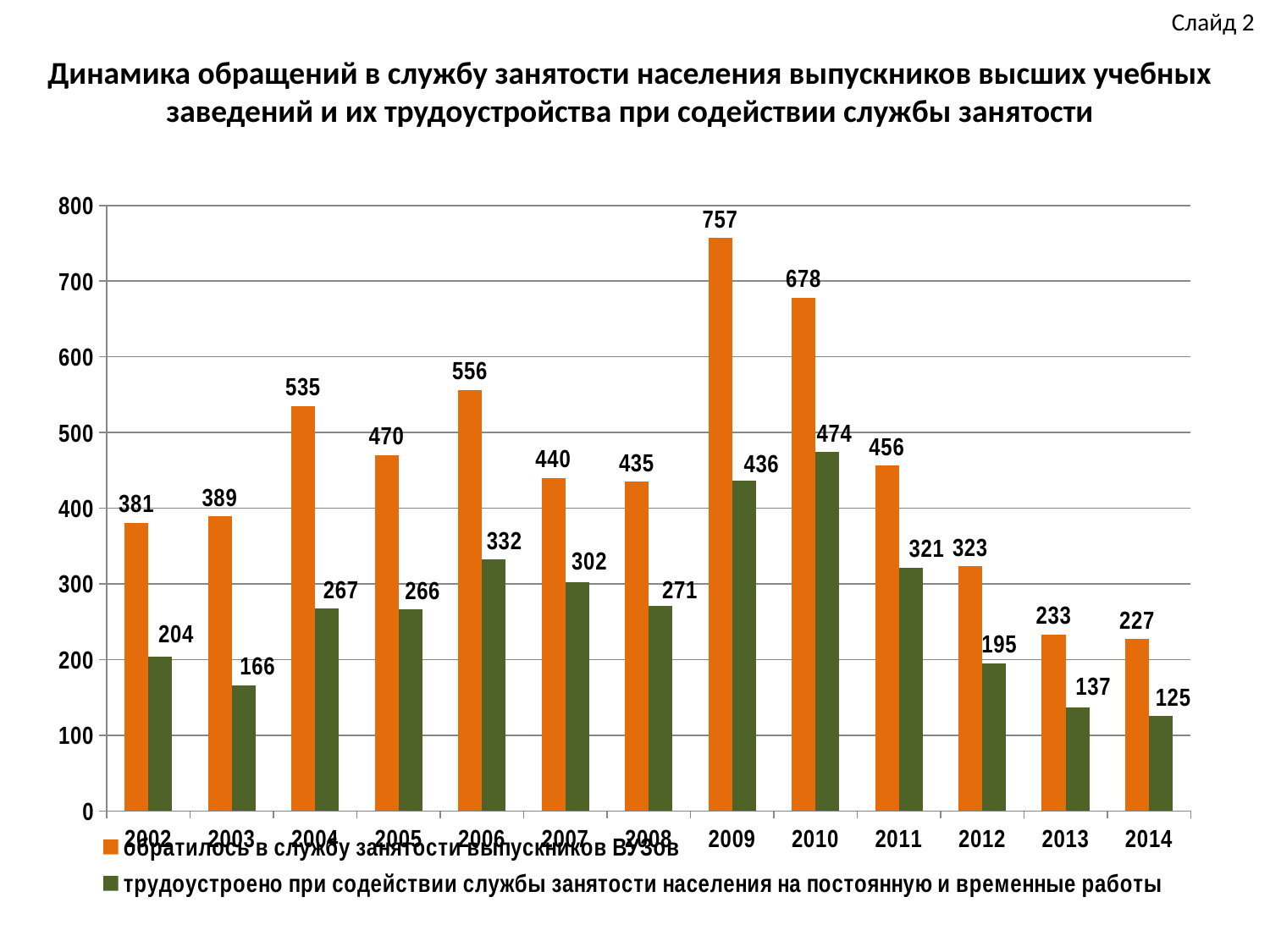
How many series does the legend list? 2 What is the difference between the two series' values in 2009? 321 In which year is the value for 'трудоустроено при содействии службы занятости населения на постоянную и временные работы' the lowest? 2014 Is the value for 'обратилось в службу занятости выпускников ВУЗов' in 2010 greater or less than 600? greater What colour are the bars for 'трудоустроено при содействии службы занятости населения на постоянную и временные работы'? dark green Do the values for 'обратилось в службу занятости выпускников ВУЗов' rise or fall from 2010 to 2014? fall In which year is the value for 'обратилось в службу занятости выпускников ВУЗов' the highest? 2009 What value is shown for 'обратилось в службу занятости выпускников ВУЗов' in 2009? 757 Which is larger: the value for 'обратилось в службу занятости выпускников ВУЗов' in 2004 or in 2006? 2006 How many years are shown on the x axis? 13 What value is shown for 'трудоустроено при содействии службы занятости населения на постоянную и временные работы' in 2010? 474 What kind of chart is shown on the slide? bar chart